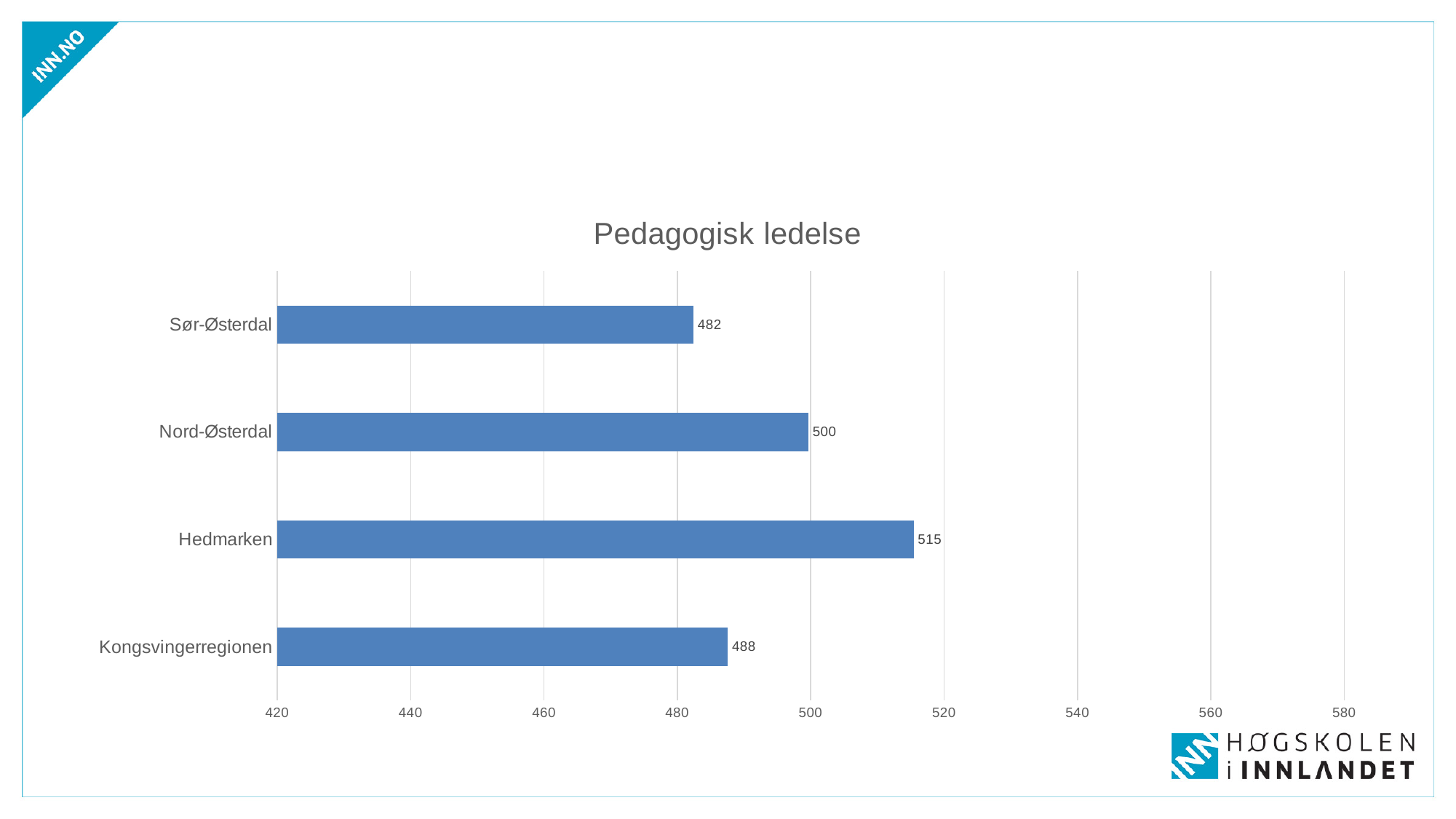
Which category has the highest value? Hedmarken What is the difference between the values for Hedmarken and Sør-Østerdal? 33 What is the value for Kongsvingerregionen? 488 Which category has the lowest value? Sør-Østerdal What is the value for Hedmarken? 515 What is the difference between the values for Nord-Østerdal and Kongsvingerregionen? 12 What is the value for Sør-Østerdal? 482 What kind of chart is shown on the slide? Bar chart How many categories are shown in the chart? 4 Which is larger, the value for Kongsvingerregionen or the value for Sør-Østerdal? Kongsvingerregionen What is the value for Nord-Østerdal? 500 Is the value for Hedmarken greater or less than 500? greater